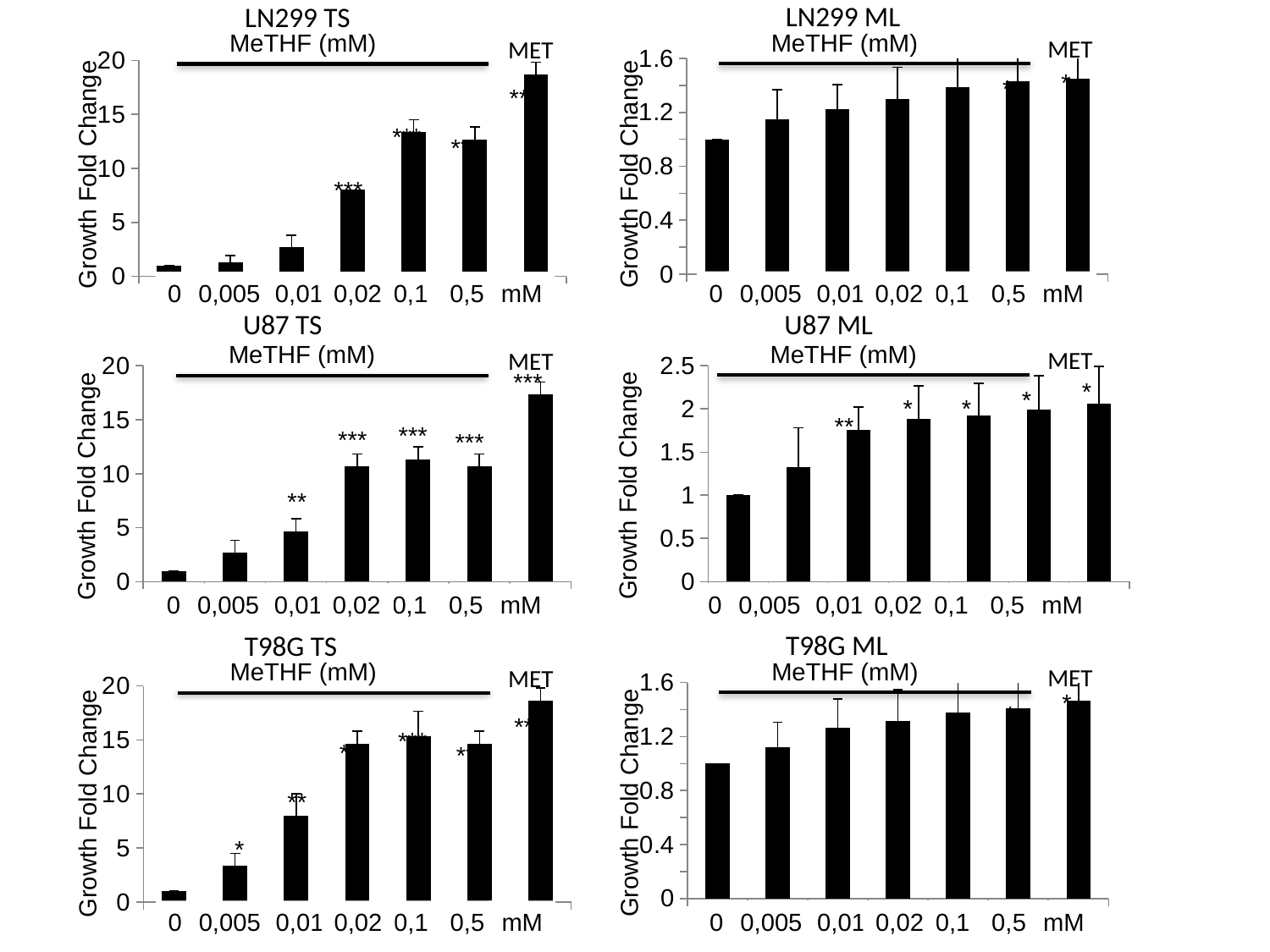
In the T98G TS chart, is the value for 0,02 mM MeTHF greater or less than 10? greater In the LN299 TS chart, is the value for 0,02 mM MeTHF greater or less than 5? greater In the U87 TS chart, which category has the lowest growth fold change? 0 In the LN299 TS chart, how many bars are plotted? 7 In the U87 ML chart, do the values generally rise or fall from left to right along the x axis? rise What kind of chart is the LN299 TS chart at the top left? bar chart In the LN299 TS chart, which category has the highest growth fold change? MET In the LN299 ML chart, is the value for 0,005 mM MeTHF greater or less than 1.2? less In the LN299 TS chart, which is larger, the value for 0,02 or the value for 0,1? 0,1 What is the y-axis label on the T98G ML chart? Growth Fold Change